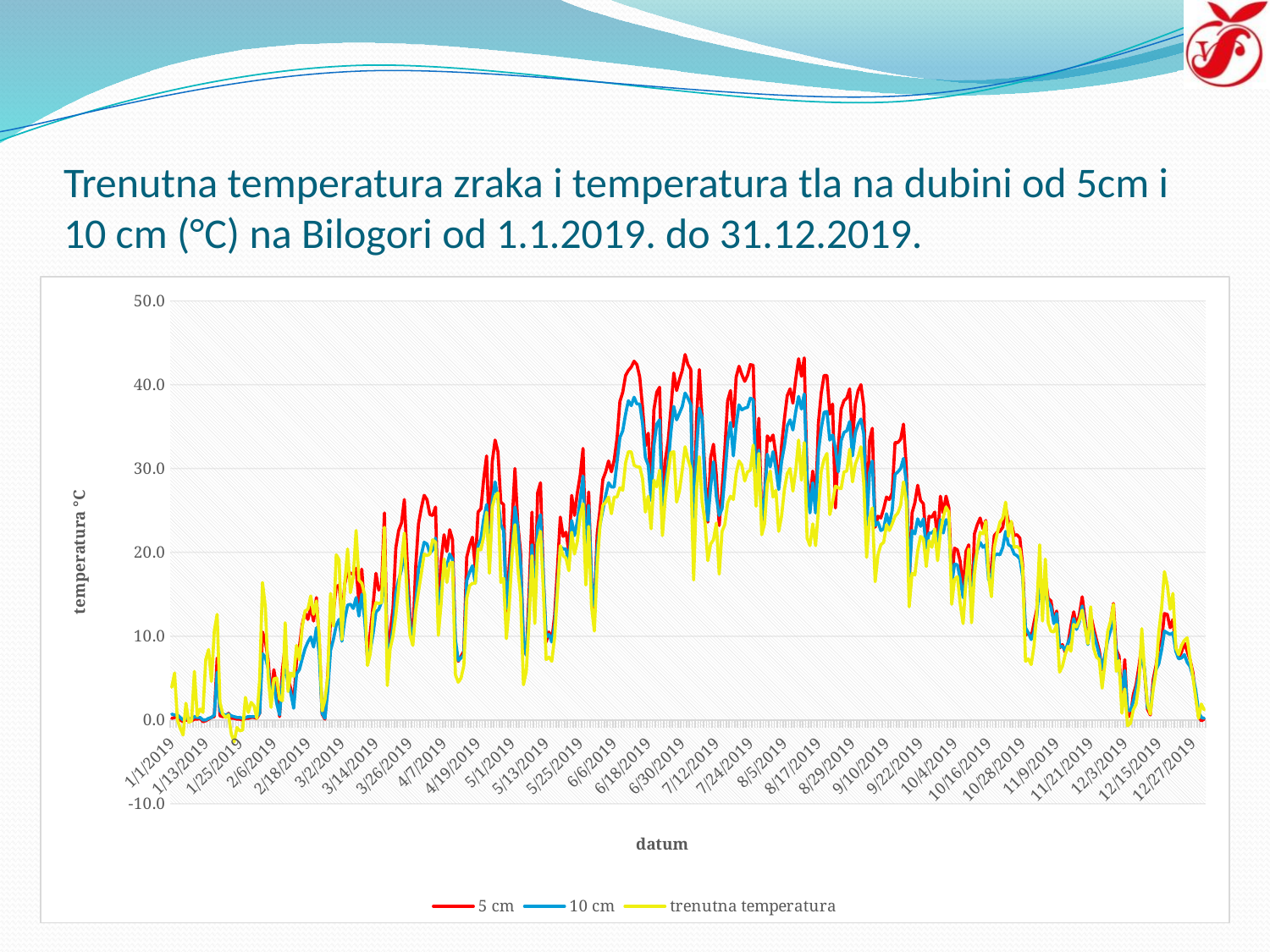
Do the temperature values generally rise or fall from January to July 2019? rise Is the highest value reached by the 10 cm series greater or less than 30.0? greater What kind of chart is shown on the slide? line chart Which series reaches the highest peak during the summer months? 5 cm What is the highest tick value shown on the vertical axis? 50.0 Is the value of the 5 cm series on 1/1/2019 greater or less than 10.0? less How many series does the legend list? 3 Do the temperature values generally rise or fall from August to December 2019? fall What is the label of the vertical axis? temperatura °C What are the names of the three series in the legend? 5 cm, 10 cm, trenutna temperatura Is the highest value reached by the trenutna temperatura series greater or less than 40.0? less